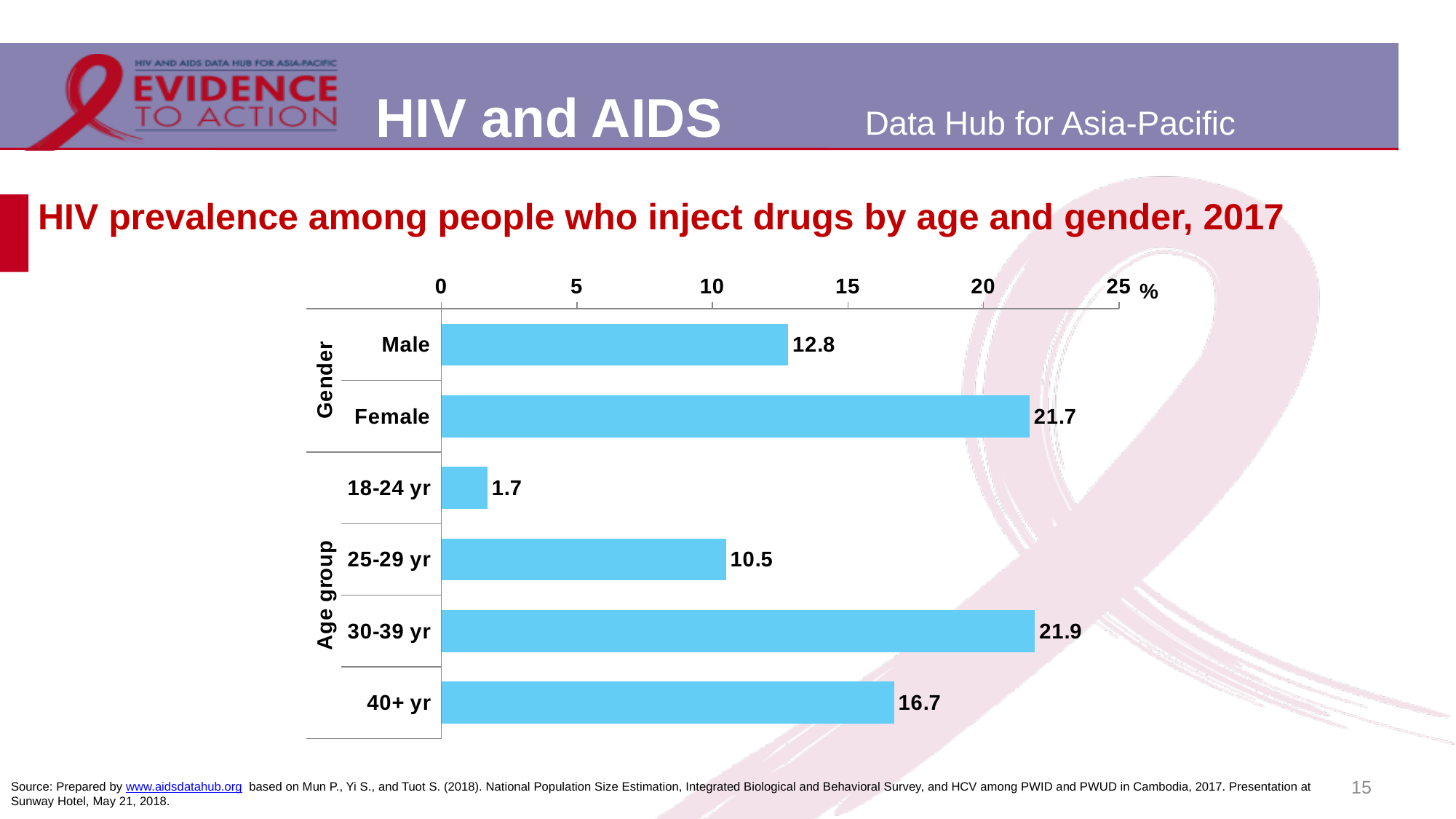
Which category has the lowest HIV prevalence on the chart? 18-24 yr What unit is shown at the end of the horizontal axis? % What kind of chart is shown on the slide? Bar chart What is the HIV prevalence for the 18-24 yr age group? 1.7 What is the HIV prevalence among female people who inject drugs? 21.7 Which has a higher HIV prevalence, the 25-29 yr group or the 40+ yr group? 40+ yr How many categories (bars) are shown on the chart? 6 What is the HIV prevalence among male people who inject drugs? 12.8 What is the difference in HIV prevalence between the 30-39 yr and 25-29 yr age groups? 11.4 What is the difference in HIV prevalence between female and male people who inject drugs? 8.9 Which age group has the highest HIV prevalence? 30-39 yr What is the HIV prevalence for the 40+ yr age group? 16.7